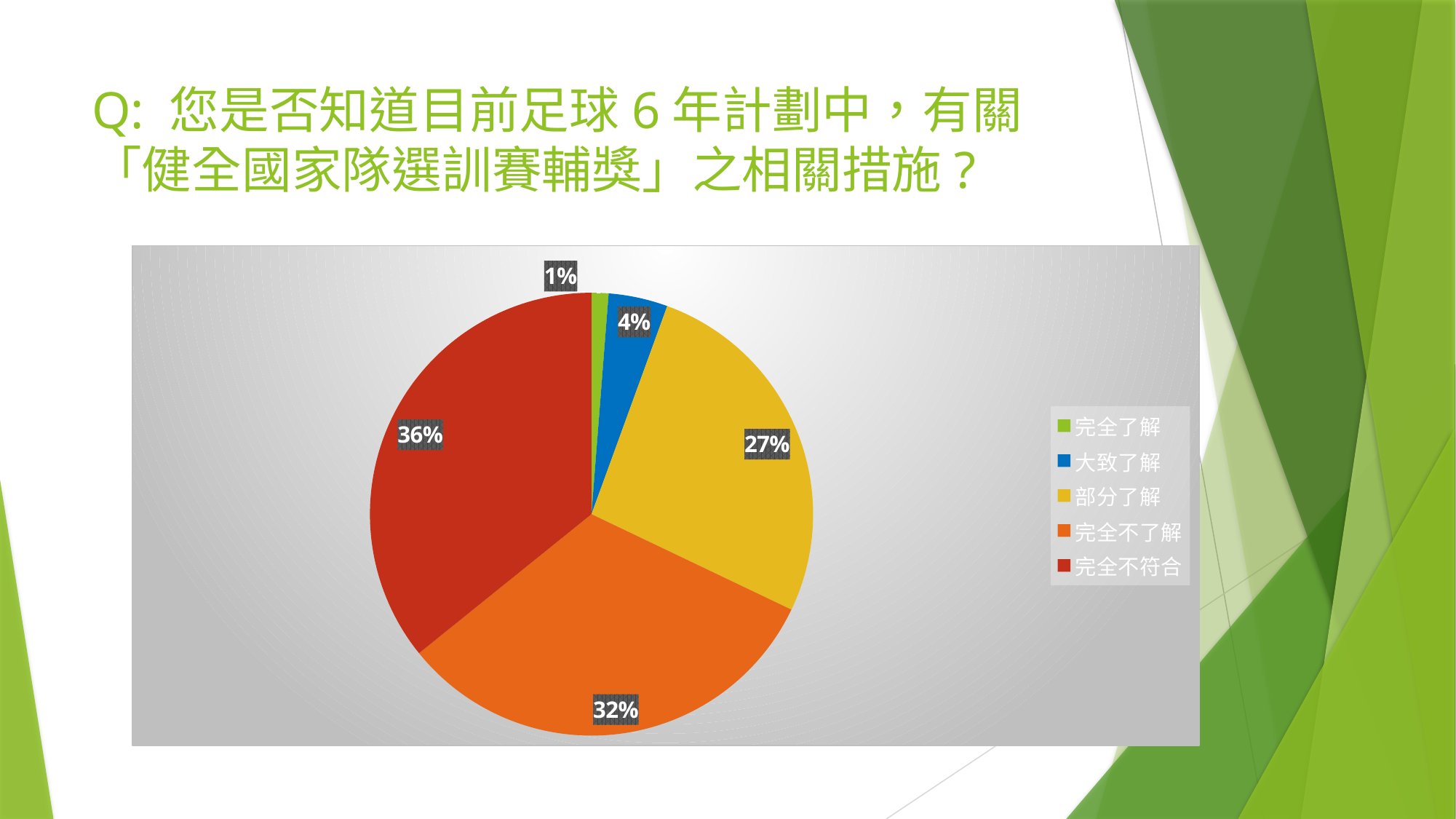
What share of the pie does 大致了解 have? 4% Which is larger, the slice for 完全不了解 or the slice for 部分了解? 完全不了解 What share of the pie does 完全了解 have? 1% What share of the pie does 完全不符合 have? 36% Which category has the largest slice of the pie? 完全不符合 How many categories does the legend list? 5 Which category has the smallest slice of the pie? 完全了解 What kind of chart is shown on the slide? pie chart What is the difference in percentage points between 完全不符合 and 部分了解? 9 What colour is the slice for 大致了解? blue